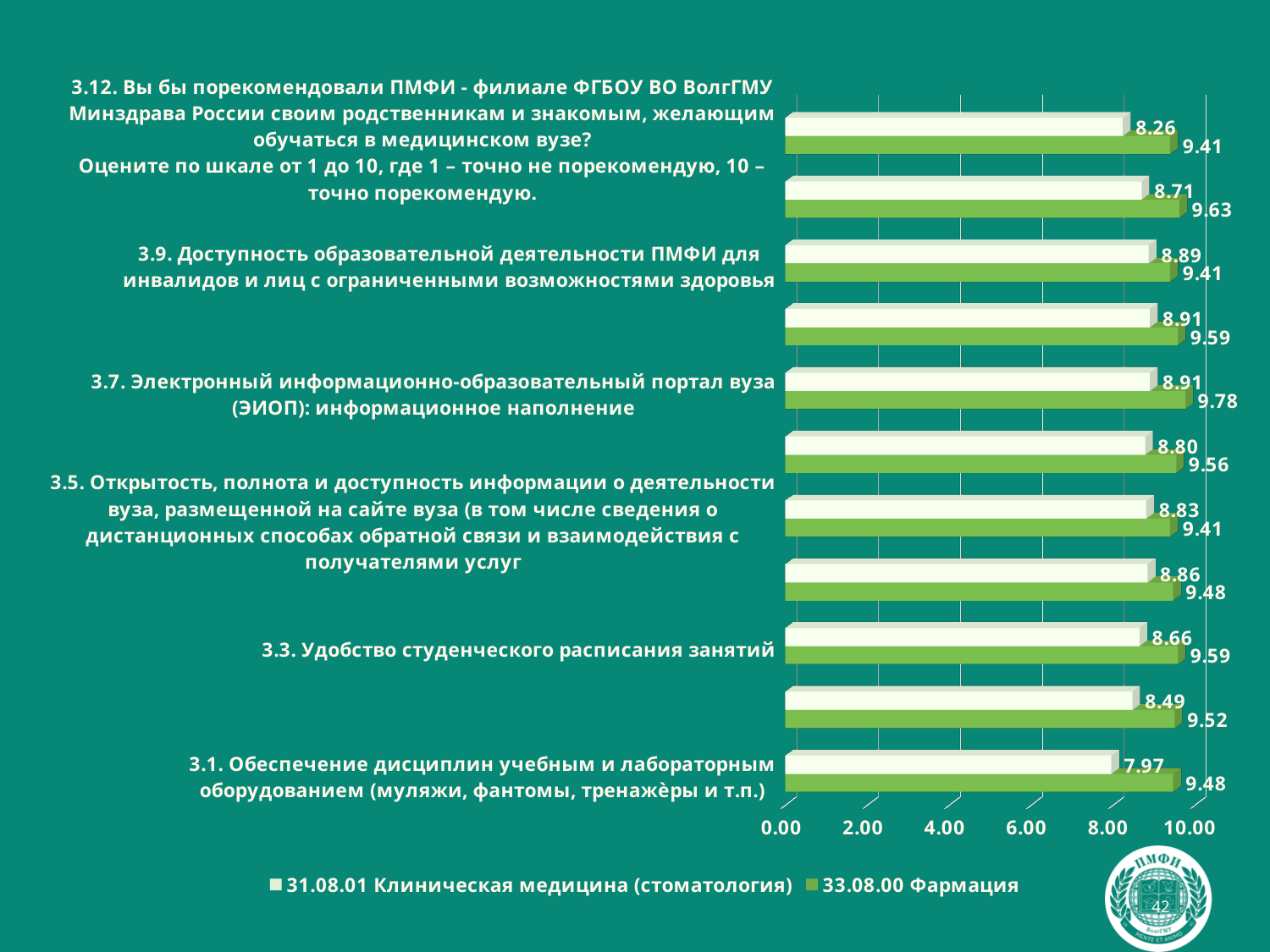
Which series is shown in green in the legend? 33.08.00 Фармация How many series does the legend list? 2 On item 3.12, which series has the larger value: 31.08.01 Клиническая медицина (стоматология) or 33.08.00 Фармация? 33.08.00 Фармация What is the value for 31.08.01 Клиническая медицина (стоматология) on item 3.3 (convenience of the student class schedule)? 8.66 Which labeled item has the lowest value for 31.08.01 Клиническая медицина (стоматология)? 3.1. Обеспечение дисциплин учебным и лабораторным оборудованием (муляжи, фантомы, тренажёры и т.п.) What kind of chart is shown on the slide? bar chart What is the value for 33.08.00 Фармация on item 3.7 (electronic information and educational portal, information content)? 9.78 What is the value for 33.08.00 Фармация on item 3.12 (recommending ПМФИ to relatives and acquaintances)? 9.41 Is the value for 31.08.01 Клиническая медицина (стоматология) on item 3.1 greater or less than 8.00? less Which labeled item has the highest value for 33.08.00 Фармация? 3.7. Электронный информационно-образовательный портал вуза (ЭИОП): информационное наполнение What is the value for 31.08.01 Клиническая медицина (стоматология) on item 3.1 (provision of disciplines with educational and laboratory equipment)? 7.97 What is the difference between the 33.08.00 Фармация and 31.08.01 Клиническая медицина (стоматология) values on item 3.1? 1.51